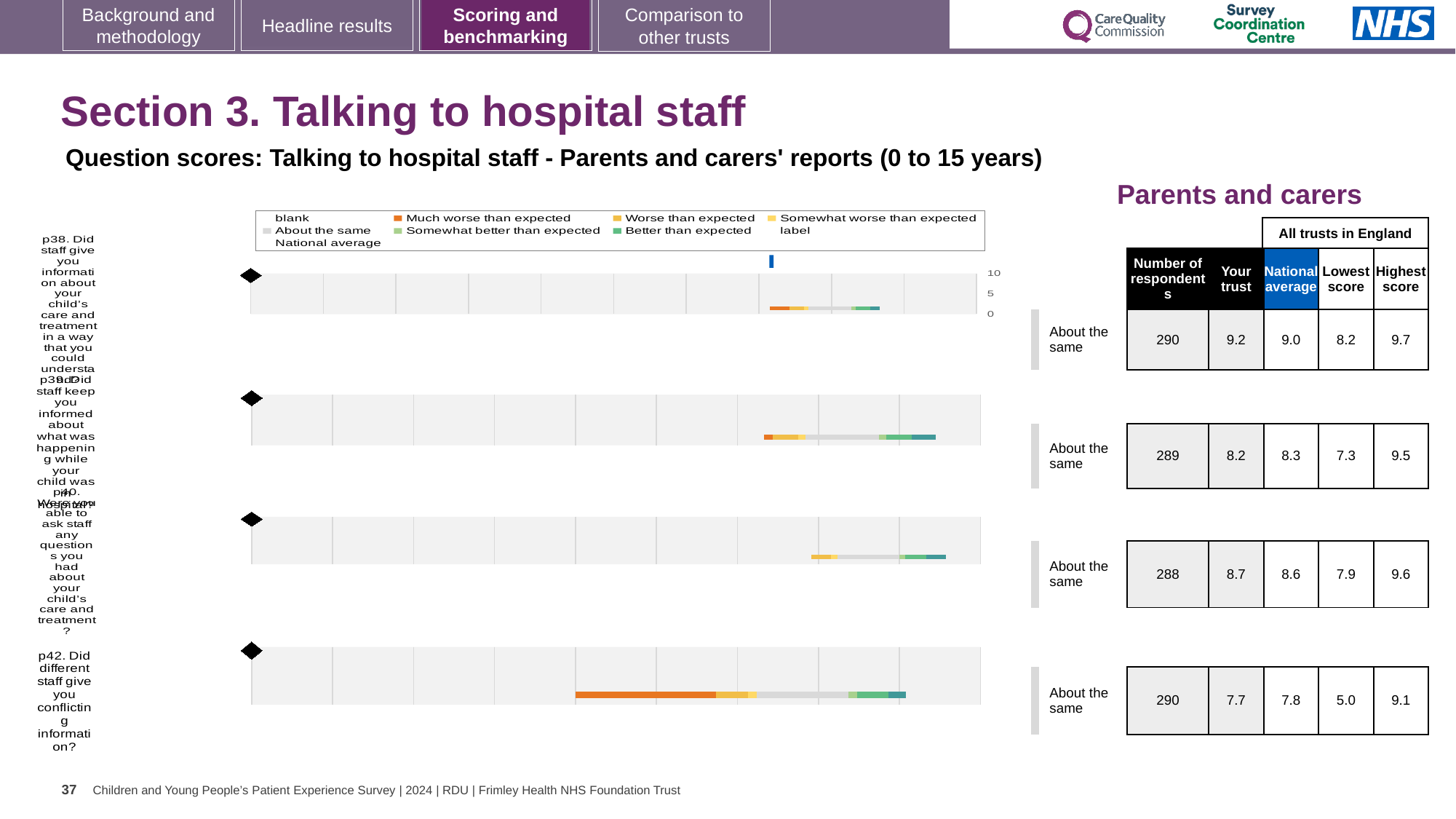
For p38 (Did staff give you information about your child's care and treatment in a way that you could understand?), what is the 'Your trust' score? 9.2 For p39 (Did staff keep you informed about what was happening while your child was in hospital?), what is the National average score? 8.3 What kind of chart is used to show the question scores on this slide? bar chart For p40, which is larger: the 'Your trust' score or the National average? Your trust Which question has the highest 'Your trust' score? p38 For p40 (Were you able to ask staff any questions you had about your child's care and treatment?), how many respondents were there? 288 Which question has the lowest 'Your trust' score? p42 For p38, what is the difference between the Highest score (9.7) and the Lowest score (8.2)? 1.5 What benchmark category is shown next to each of the four question charts? About the same In the chart legend, which colour represents 'Much worse than expected'? orange How many question charts (p38 to p42) are shown on the slide? 4 For p42 (Did different staff give you conflicting information?), what is the Lowest score among all trusts in England? 5.0